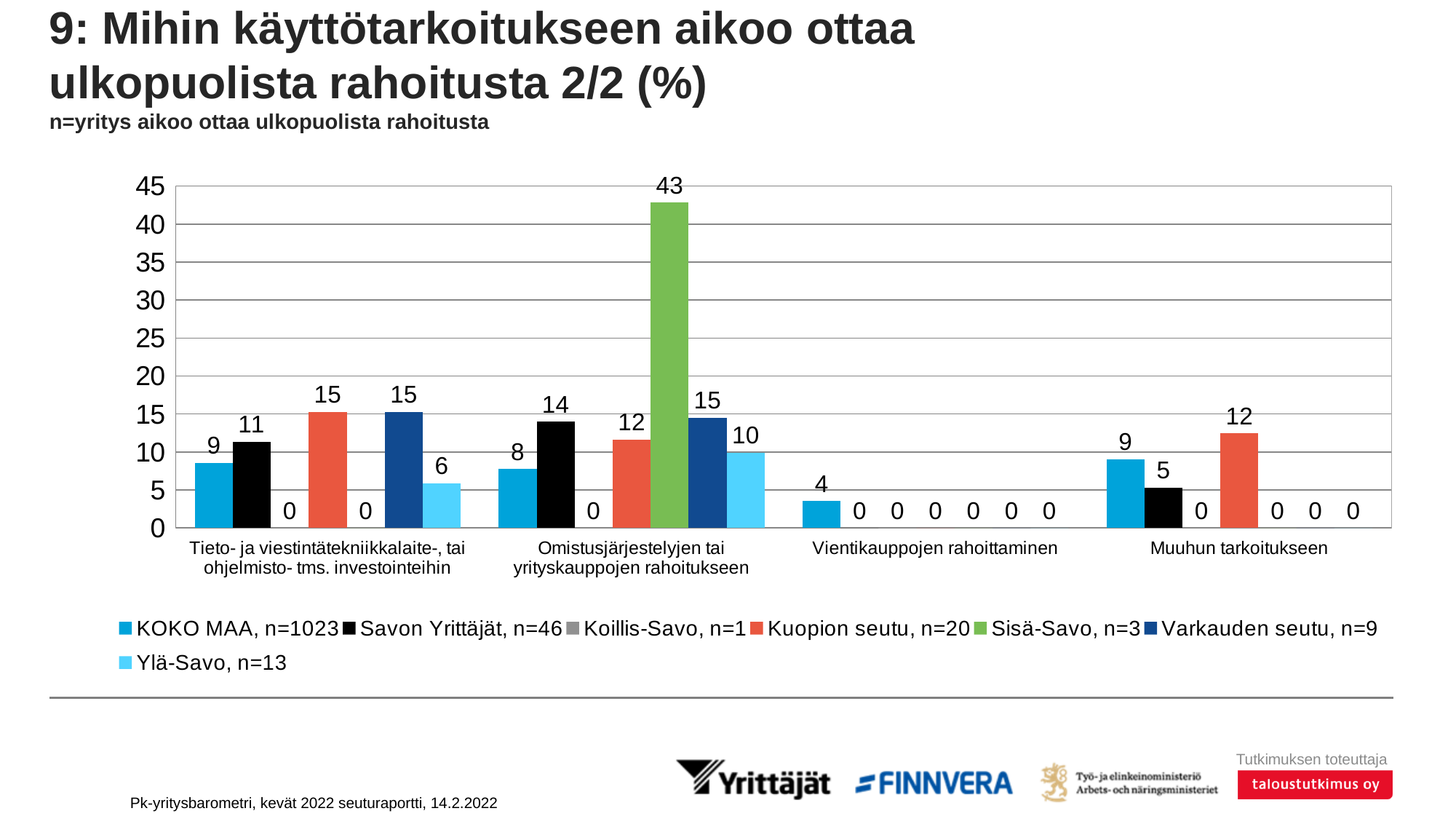
How many series does the legend list? 7 What is the value for Ylä-Savo in the category "Tieto- ja viestintätekniikkalaite-, tai ohjelmisto- tms. investointeihin"? 6 How many categories are shown on the x axis? 4 Is the value for Sisä-Savo in the category "Omistusjärjestelyjen tai yrityskauppojen rahoitukseen" greater or less than 40? greater What kind of chart is shown on the slide? Bar chart Which series has the lowest value in the category "Muuhun tarkoitukseen" among KOKO MAA, Savon Yrittäjät and Kuopion seutu? Savon Yrittäjät What is the value for KOKO MAA in the category "Vientikauppojen rahoittaminen"? 4 What is the value for Kuopion seutu in the category "Muuhun tarkoitukseen"? 12 What is the value for Sisä-Savo in the category "Omistusjärjestelyjen tai yrityskauppojen rahoitukseen"? 43 In the category "Tieto- ja viestintätekniikkalaite-, tai ohjelmisto- tms. investointeihin", which is larger: the value for Savon Yrittäjät or the value for Kuopion seutu? Kuopion seutu What is the difference between the Sisä-Savo value and the Varkauden seutu value in the category "Omistusjärjestelyjen tai yrityskauppojen rahoitukseen"? 28 Which series has the highest value in the category "Omistusjärjestelyjen tai yrityskauppojen rahoitukseen"? Sisä-Savo